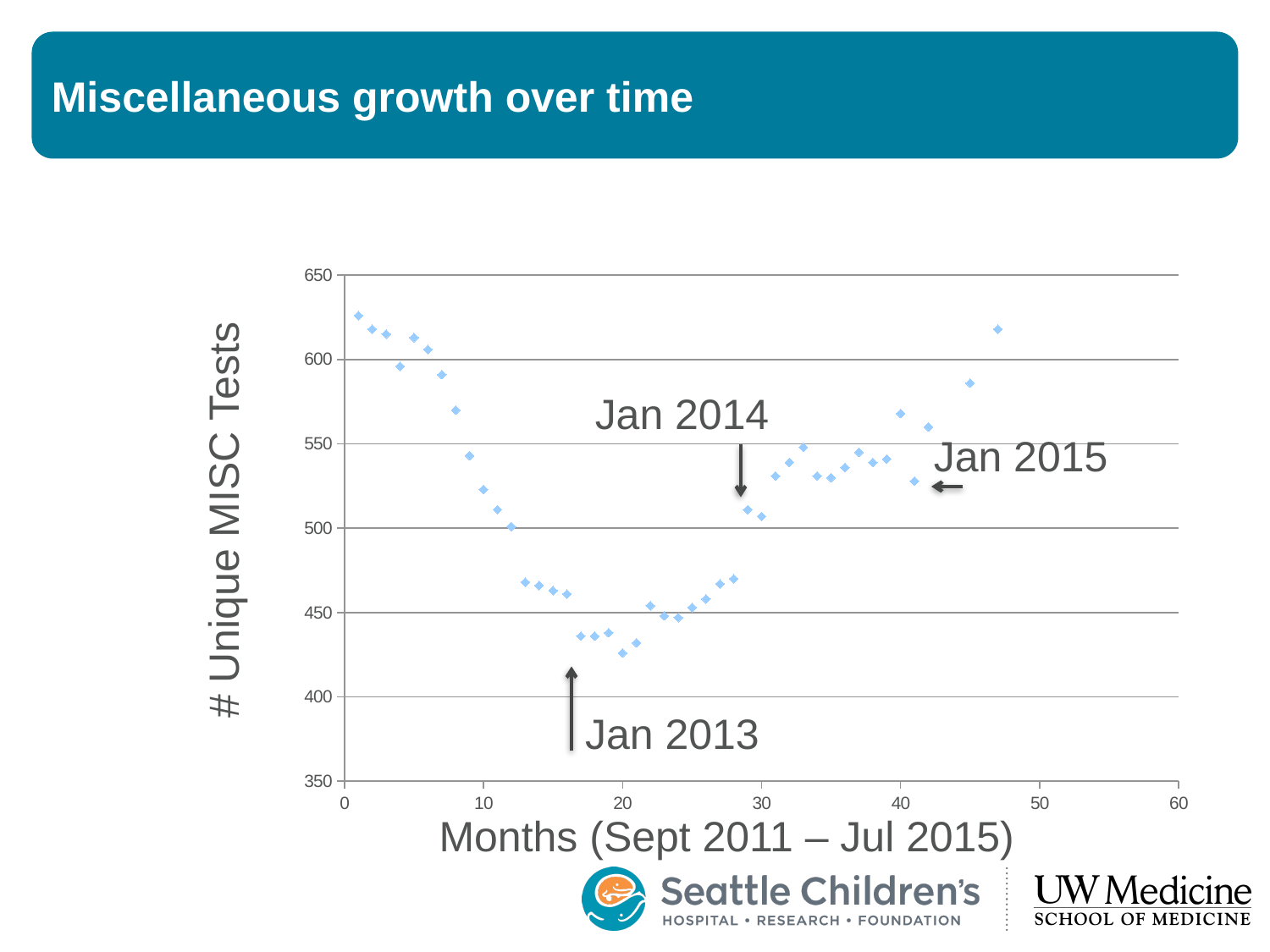
Is the value for month 8 greater or less than 550? greater What is the label on the y axis? # Unique MISC Tests Which is larger, the value at month 1 or the value at month 20? Month 1 What kind of chart is shown on the slide? Scatter chart Is the value for month 20 greater or less than 450? less Is the value for month 16 greater or less than 500? less Do the values rise or fall over the first 20 months? Fall Which is larger, the value at month 30 or the value at month 47? Month 47 Do the values rise or fall from month 20 to month 47? Rise